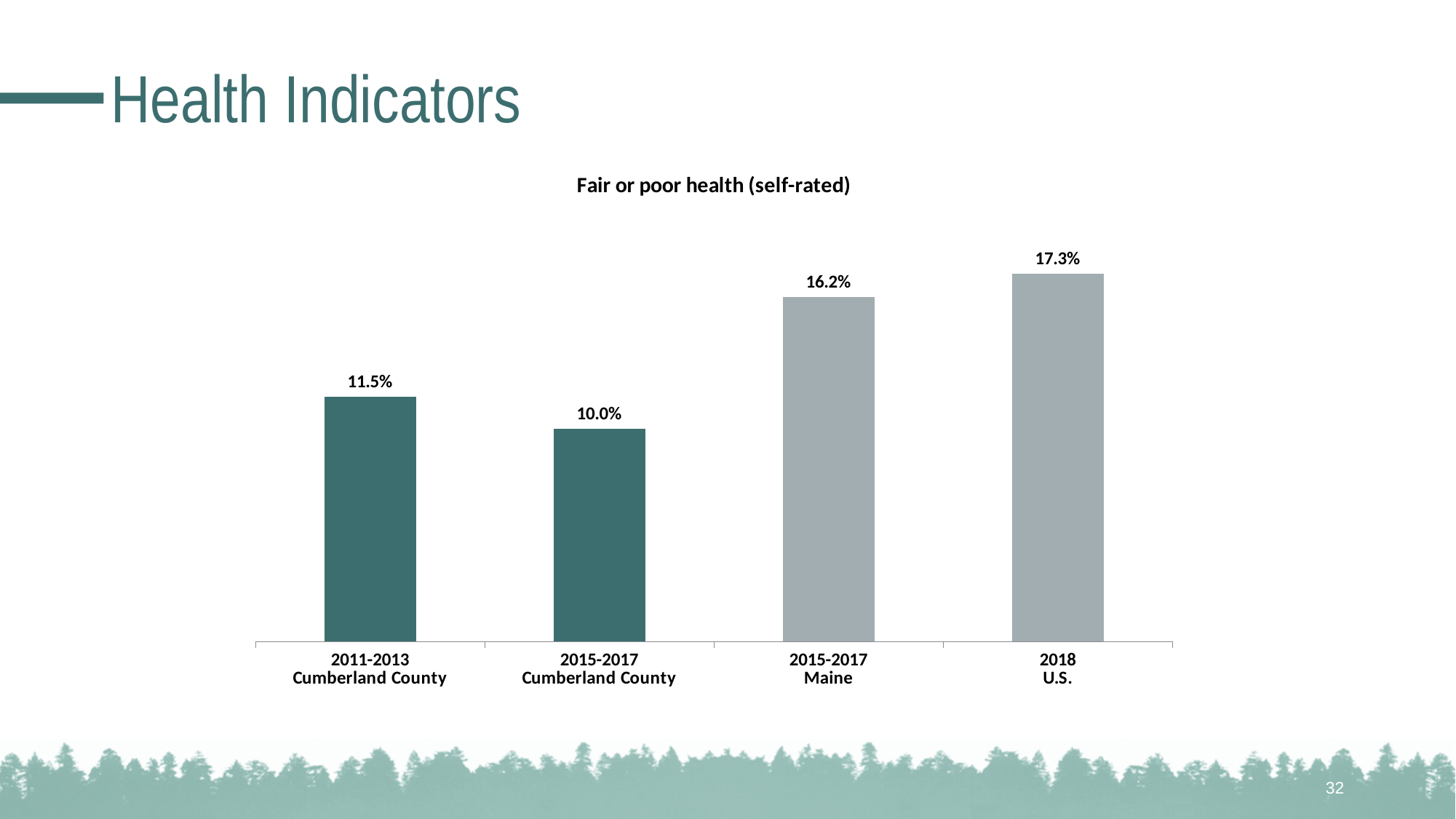
What is the value for 2011-2013 Cumberland County? 11.5% How many categories are shown in the chart? 4 What is the value for 2018 U.S.? 17.3% What is the difference between the 2011-2013 and 2015-2017 Cumberland County values? 1.5% What is the value for 2015-2017 Maine? 16.2% Which category has the lowest value? 2015-2017 Cumberland County What is the title of the chart? Fair or poor health (self-rated) Which category has the highest value? 2018 U.S. What kind of chart is shown on the slide? Bar chart Which is larger, the value for 2015-2017 Maine or the value for 2011-2013 Cumberland County? 2015-2017 Maine What is the value for 2015-2017 Cumberland County? 10.0% What is the difference between the 2018 U.S. value and the 2015-2017 Maine value? 1.1%